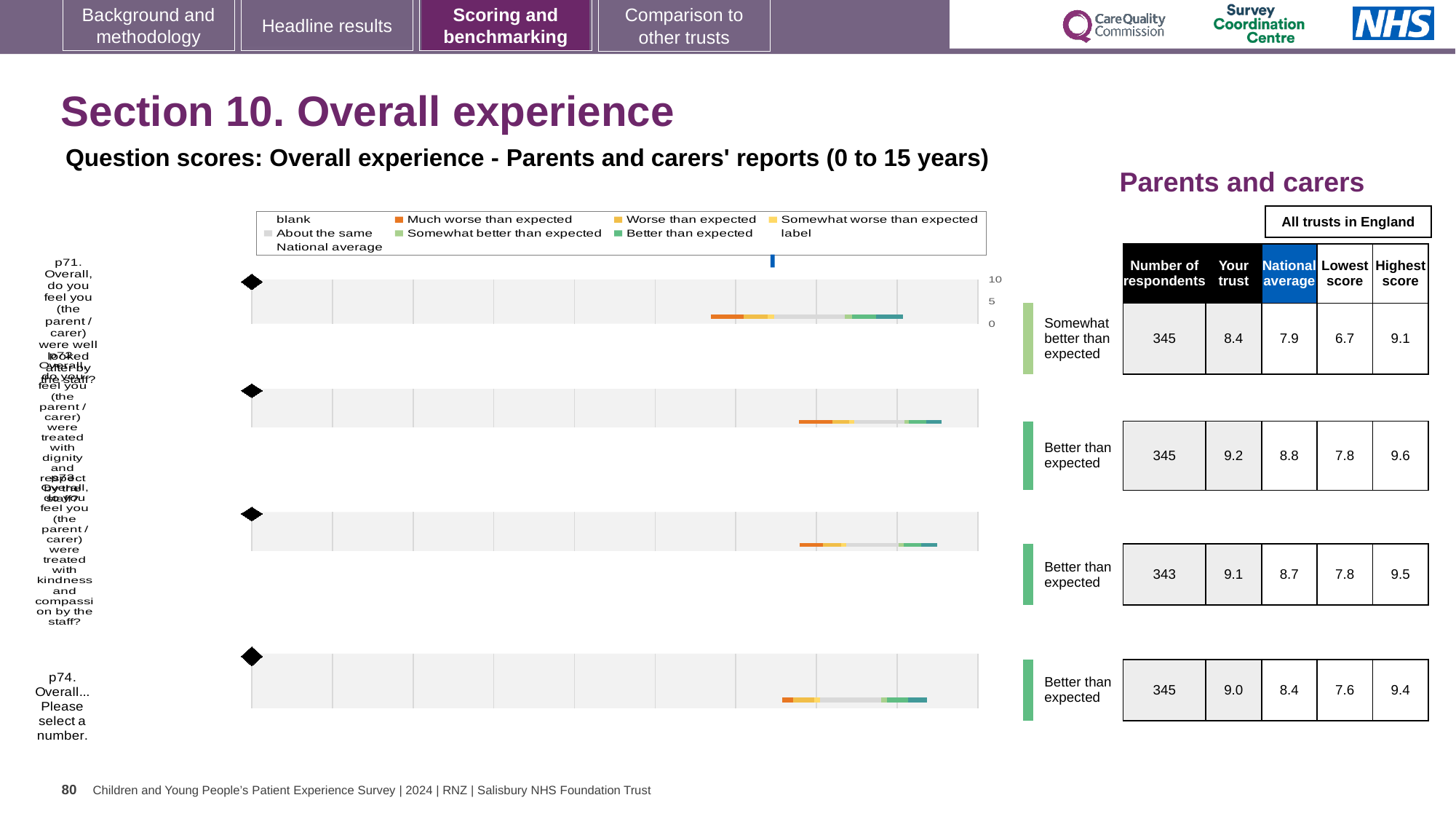
Which row has the lowest 'Your trust' score in the table beside the chart? the first row, p71 (8.4) How many question rows (bars) are plotted in the chart? 4 In the table beside the chart, what is the 'Your trust' score for the first (top) row, p71? 8.4 What kind of chart is used to show the question scores on this slide? bar chart How many entries does the chart legend list? 9 What is the title of the chart? Question scores: Overall experience - Parents and carers' reports (0 to 15 years) What benchmark category is shown next to the first (top) bar, p71? Somewhat better than expected For the last (bottom) row, p74, which is larger: the 'Your trust' score or the national average? Your trust (9.0) Which row has the highest 'Your trust' score in the table beside the chart? the second row (9.2) In the table beside the chart, what is the national average for the last (bottom) row, p74? 8.4 In the table beside the chart, how many respondents are listed for the third row? 343 By how much does the 'Your trust' score exceed the national average for the first (top) row, p71? 0.5